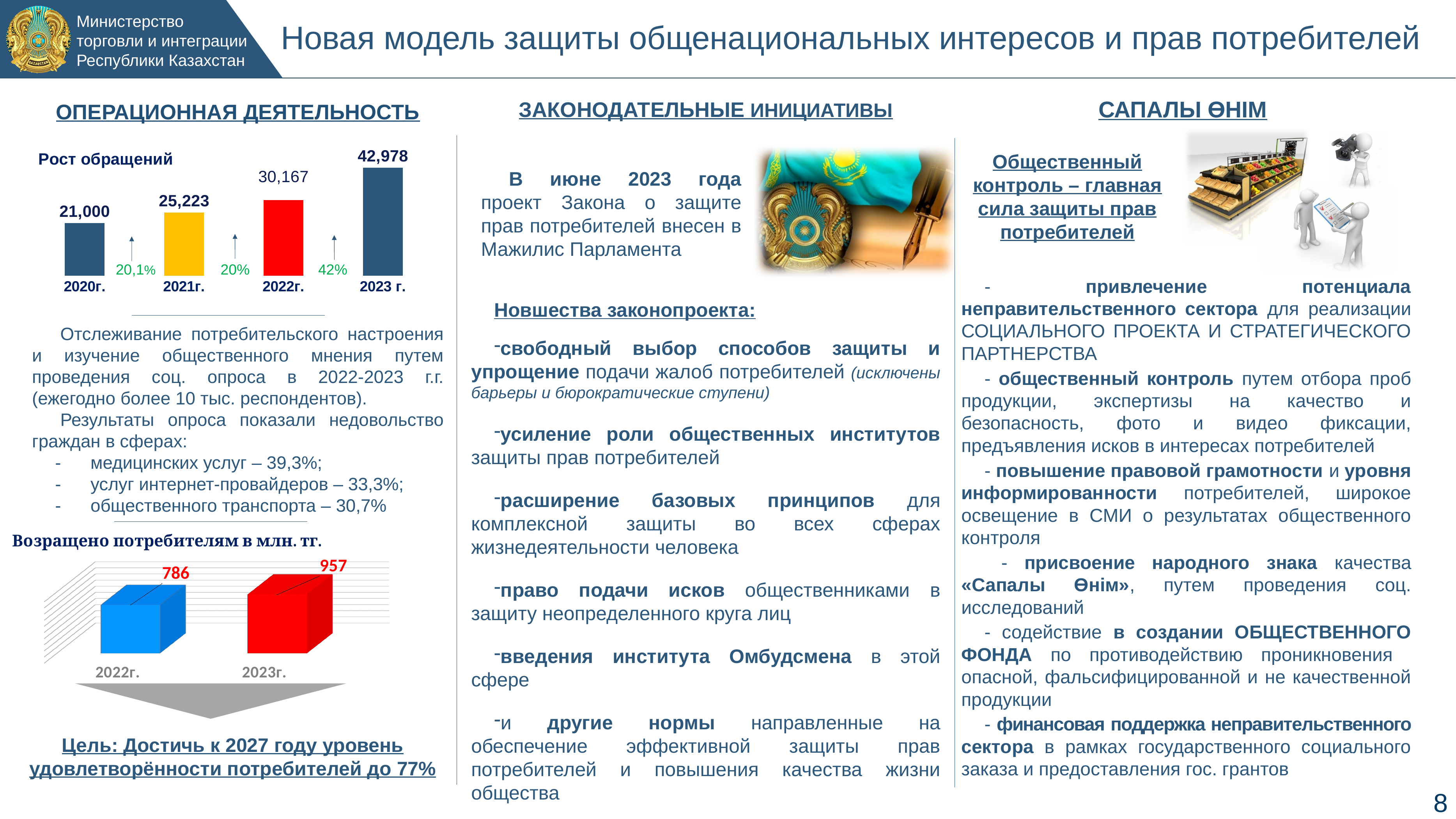
In the 'Рост обращений' chart, how many years are shown? 4 In the 'Рост обращений' chart, do the values rise or fall from 2020г. to 2023 г.? rise In the 'Рост обращений' chart, which year has the highest value? 2023 г. In the 'Возращено потребителям в млн. тг.' chart, what is the value for 2023г.? 957 In the 'Рост обращений' chart, what is the difference between the values for 2023 г. and 2022г.? 12,811 In the 'Рост обращений' chart, what is the value for 2020г.? 21,000 In the 'Рост обращений' chart, what is the value for 2023 г.? 42,978 In the 'Рост обращений' chart, what is the value for 2022г.? 30,167 In the 'Рост обращений' chart, what growth percentage is shown between 2022г. and 2023 г.? 42% In the 'Рост обращений' chart, which year has the lowest value? 2020г. In the 'Возращено потребителям в млн. тг.' chart, what is the difference between the values for 2023г. and 2022г.? 171 What kind of chart is 'Возращено потребителям в млн. тг.'? bar chart